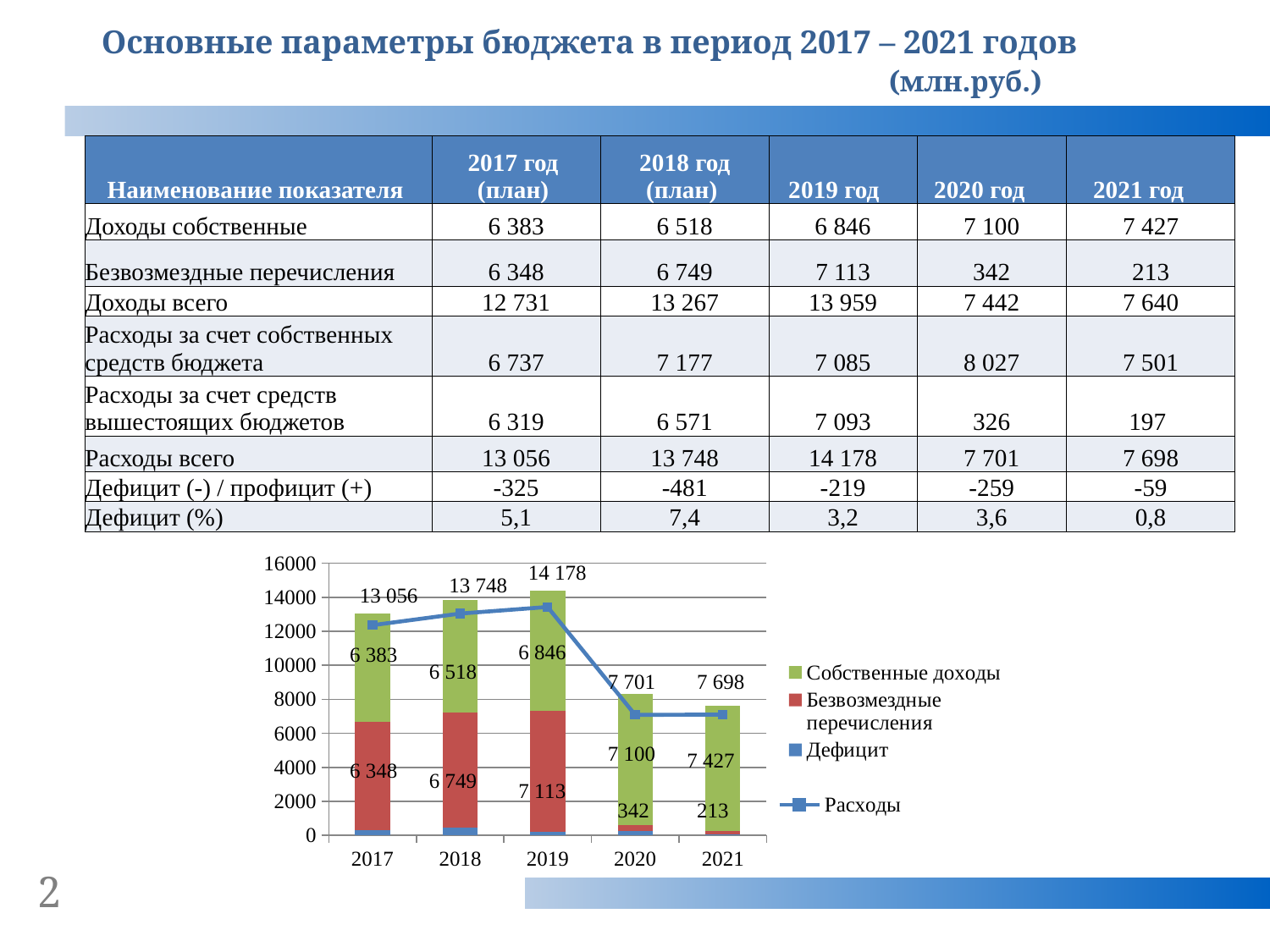
In the chart, what is the value of Безвозмездные перечисления for 2020? 342 In the chart, which year has the highest value of Расходы? 2019 What type of chart is shown on the slide? Stacked bar chart with a line In the chart, do the values of Собственные доходы rise or fall from 2017 to 2021? Rise Which series in the chart is drawn as a line rather than bars? Расходы In the chart, what is the value of the Расходы line for 2019? 14 178 How many years are shown on the x axis of the chart? 5 In the chart, which year has the lowest value of Безвозмездные перечисления? 2021 In the chart, which is larger: Собственные доходы in 2021 or Собственные доходы in 2017? Собственные доходы in 2021 In the chart, what is the difference between Расходы in 2019 and Расходы in 2020? 6 477 In the chart, what is the value of Собственные доходы for 2019? 6 846 How many series does the chart legend list? 4